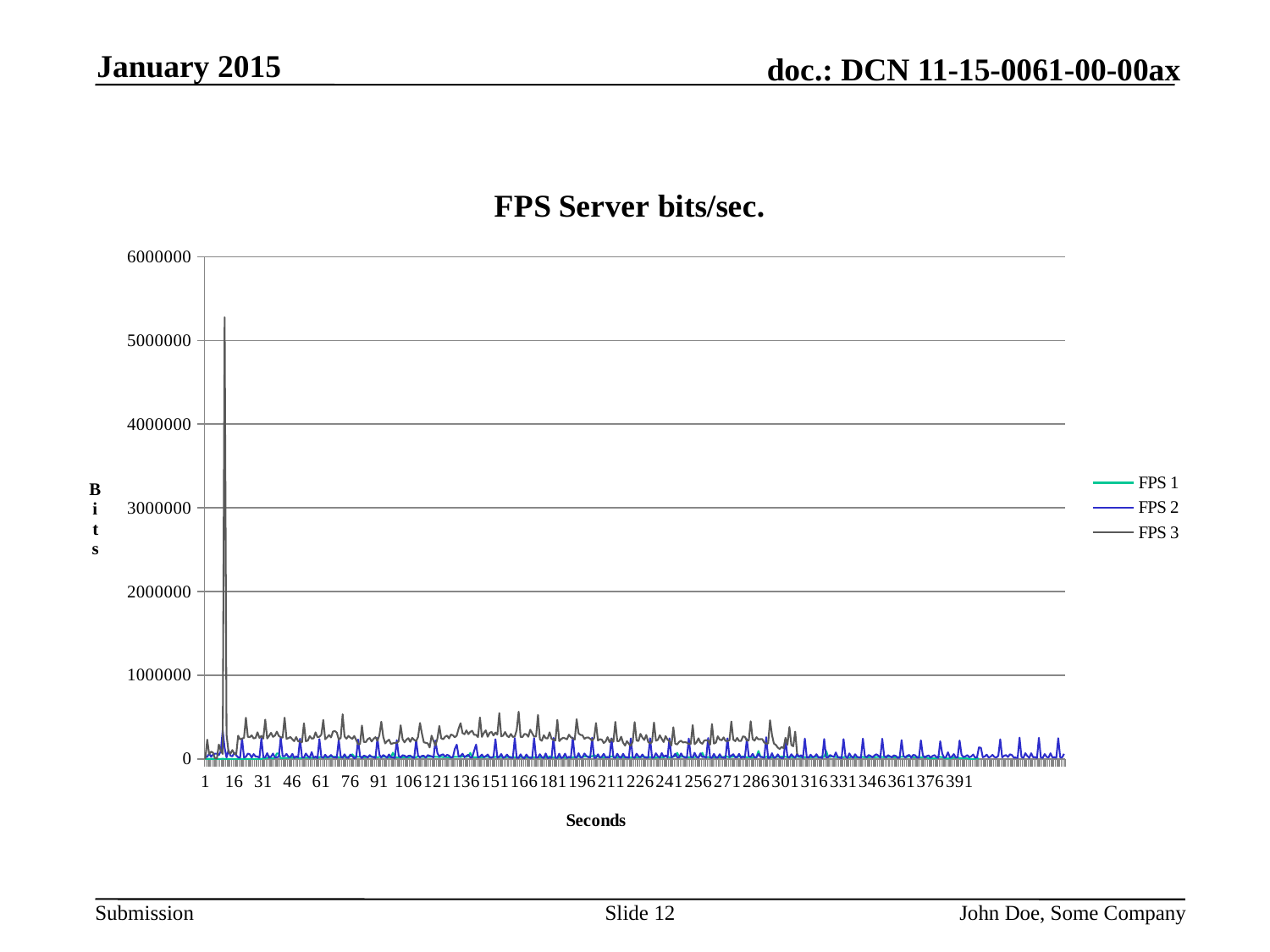
Is the highest peak of the FPS 3 series greater or less than 5000000? greater What is the title of the chart? FPS Server bits/sec. Is the highest peak of the FPS 2 series greater or less than 1000000? less What is the first value shown on the x axis? 1 Which series reaches the highest peak value in the chart? FPS 3 Which series has the larger peak value, FPS 2 or FPS 3? FPS 3 Is the highest peak of the FPS 3 series greater or less than 6000000? less What is the label of the x axis? Seconds What kind of chart is shown on the slide? line chart What is the highest value shown on the y axis? 6000000 How many series does the legend list? 3